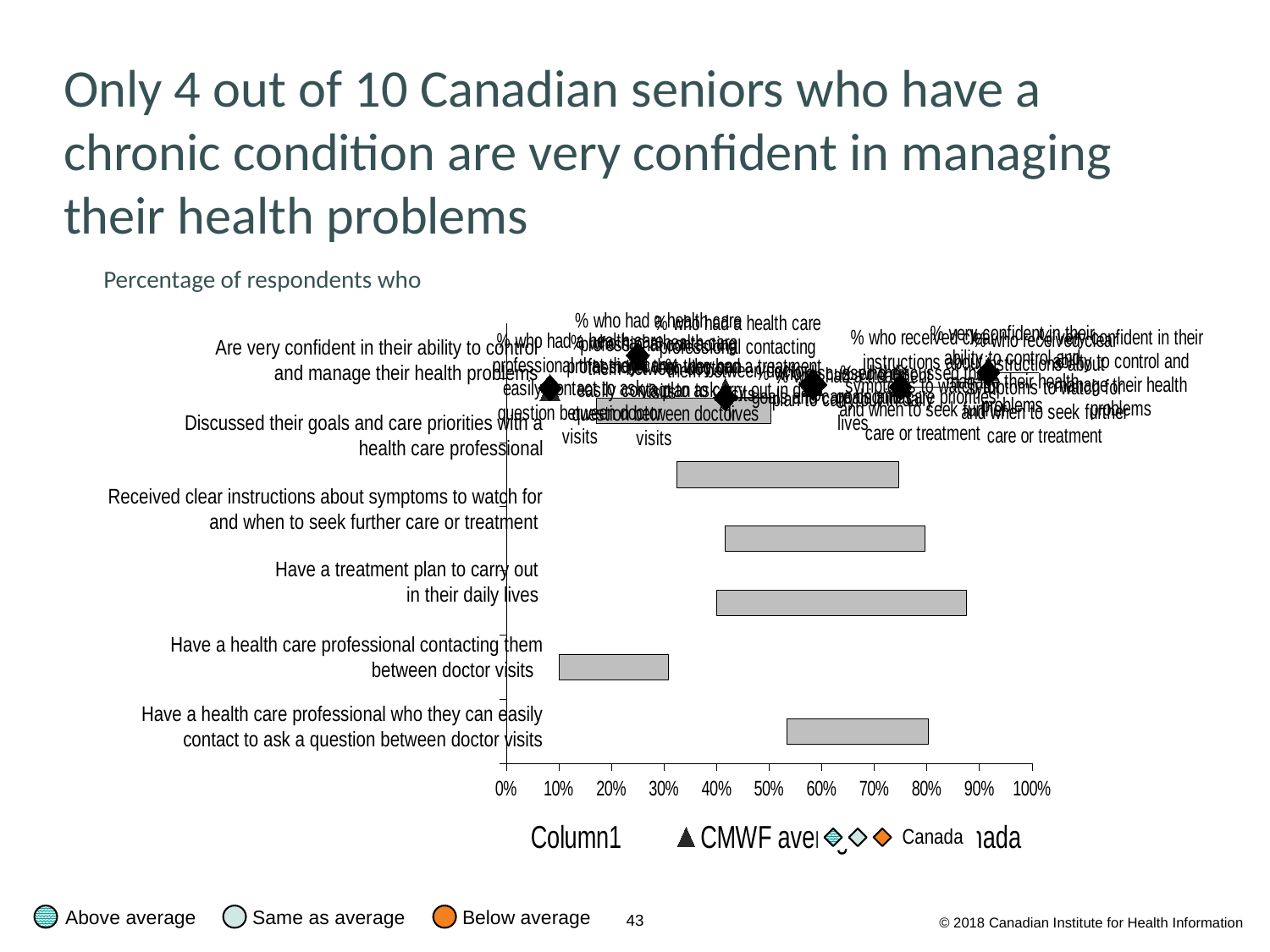
What kind of chart is shown on the slide? bar chart How many series does the chart legend list? 3 Is the right end of the bar for 'Have a health care professional contacting them between doctor visits' greater or less than 40%? less Which category has the bar that lies furthest to the left (lowest values) on the chart? Have a health care professional contacting them between doctor visits What is the subtitle printed above the chart? Percentage of respondents who Which category has the bar that extends furthest to the right on the chart? Have a treatment plan to carry out in their daily lives Which bar extends further to the right: 'Have a treatment plan to carry out in their daily lives' or 'Have a health care professional contacting them between doctor visits'? Have a treatment plan to carry out in their daily lives Is the left end of the bar for 'Discussed their goals and care priorities with a health care professional' greater or less than 20%? greater What is the highest value shown on the horizontal axis of the chart? 100% How many categories are listed on the vertical axis of the chart? 6 Is the left end of the bar for 'Have a health care professional who they can easily contact to ask a question between doctor visits' greater or less than 50%? greater